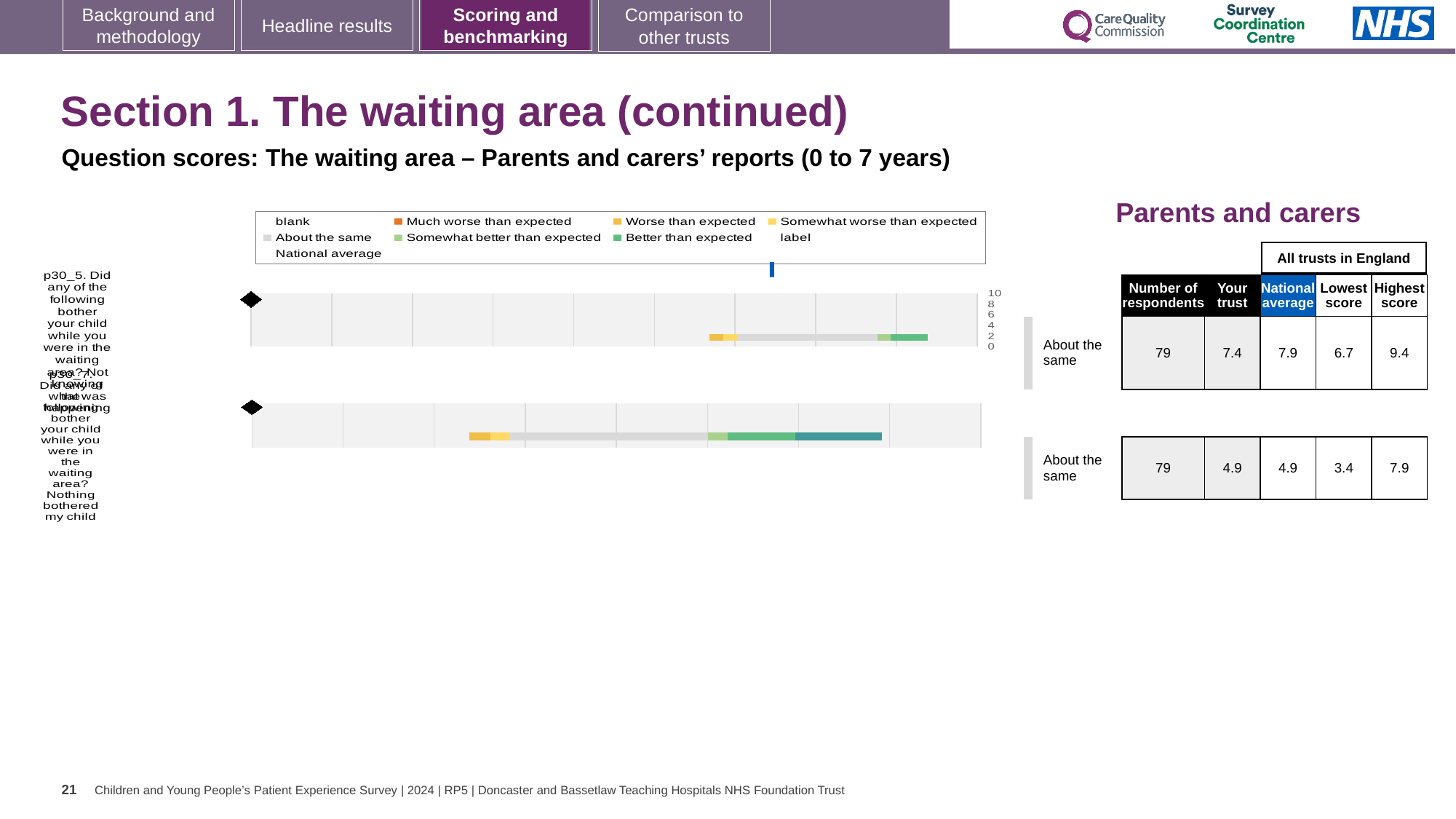
How many question charts are shown on the slide? 2 For the top chart (p30_5), which is larger: the 'Your trust' score or the national average? National average How many respondents are reported for the bottom chart (p30_7)? 79 For the bottom chart (p30_7), what is the difference between the highest score (7.9) and the lowest score (3.4)? 4.5 For the top chart (p30_5, Not knowing what was happening), what is the national average score? 7.9 What kind of chart is used to show the question scores on this slide? bar chart For the bottom chart (p30_7, Nothing bothered my child), what is the lowest score among all trusts in England? 3.4 For the bottom chart (p30_7, Nothing bothered my child), what is the 'Your trust' score? 4.9 For the top chart (p30_5), what is the difference between the highest score (9.4) and the lowest score (6.7)? 2.7 For the top chart (p30_5, Not knowing what was happening), what is the 'Your trust' score? 7.4 For the top chart (p30_5), what is the highest score among all trusts in England? 9.4 What benchmark category is the trust placed in for the bottom chart (p30_7)? About the same